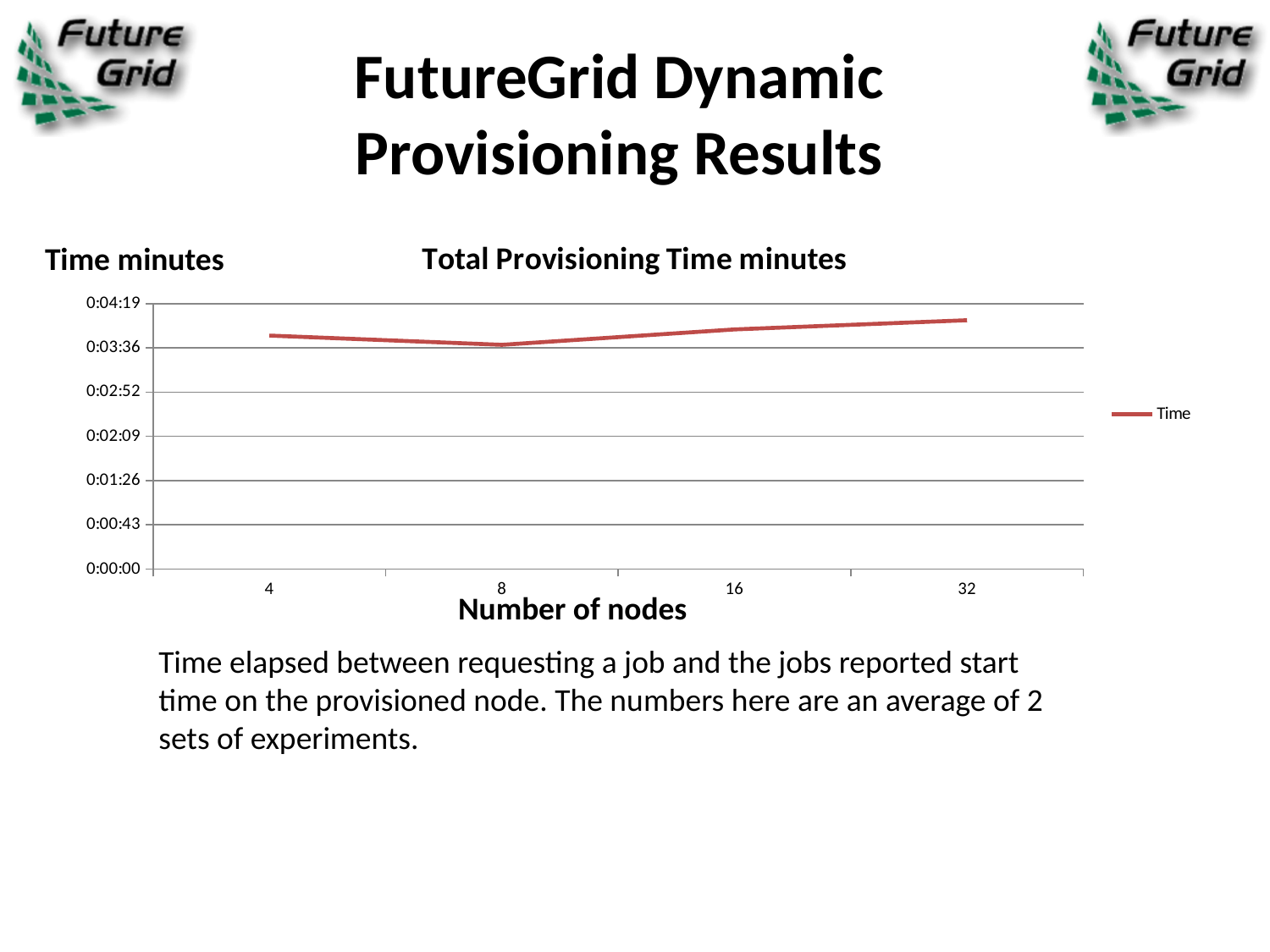
What is the label of the x axis? Number of nodes How many node counts are plotted along the x axis? 4 What is the name of the series in the legend? Time For which number of nodes is the provisioning time highest? 32 Which has the larger provisioning time, 4 nodes or 16 nodes? 16 How many series does the legend list? 1 What is the title of the chart? Total Provisioning Time minutes Which has the larger provisioning time, 8 nodes or 32 nodes? 32 Is the provisioning time for 4 nodes greater or less than 0:02:52? greater Is the provisioning time for 32 nodes greater or less than 0:03:36? greater What kind of chart is shown on the slide? line chart For which number of nodes is the provisioning time lowest? 8